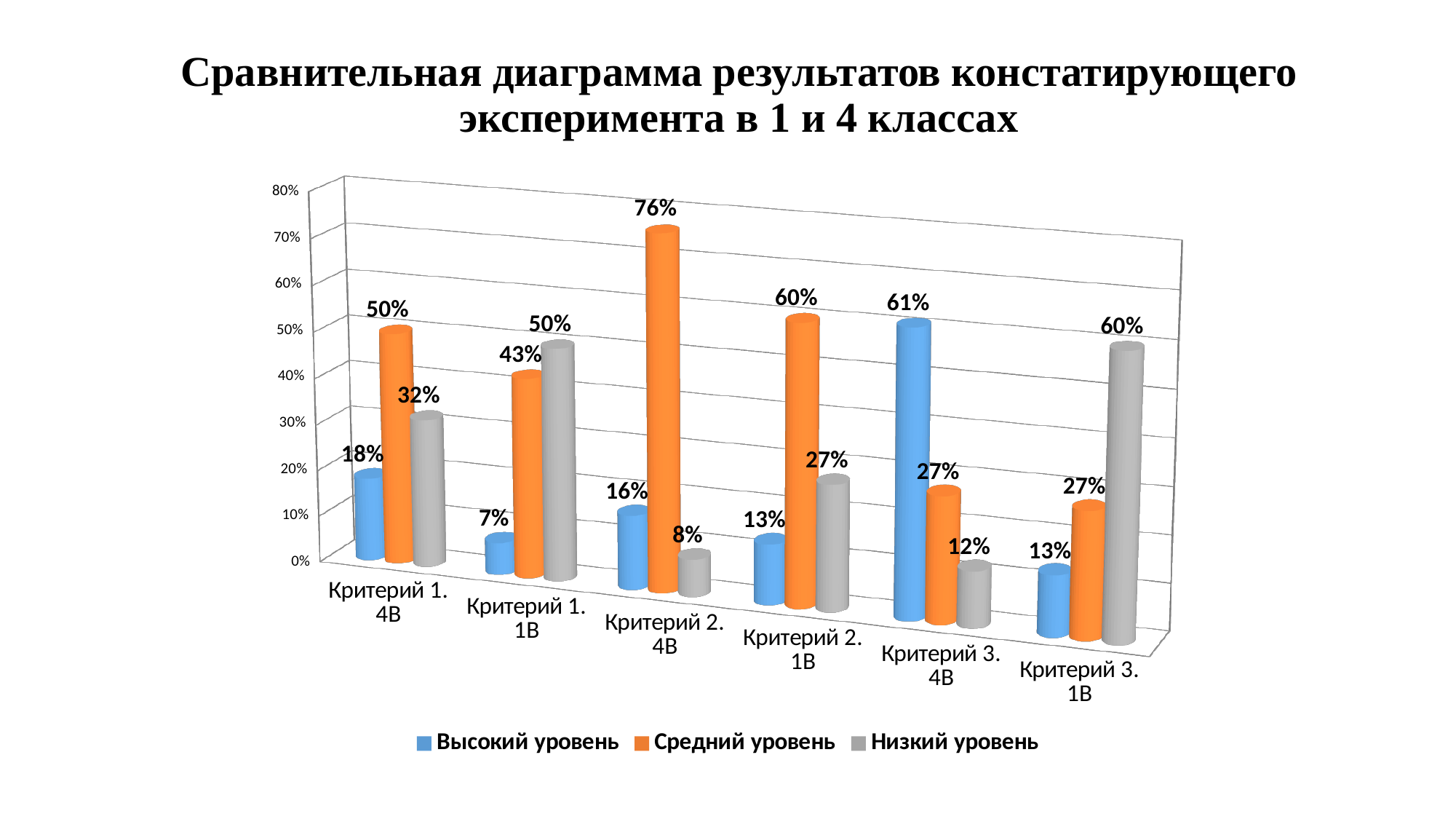
What is the value of Низкий уровень for Критерий 1. 1В? 50% What is the value of Высокий уровень for Критерий 1. 1В? 7% Which category has the lowest value for Низкий уровень? Критерий 2. 4В Which series is shown in orange in the legend? Средний уровень What kind of chart is shown on the slide? Bar chart How many series does the legend list? 3 What is the difference between Низкий уровень for Критерий 3. 1В and Низкий уровень for Критерий 3. 4В? 48% What is the value of Высокий уровень for Критерий 3. 4В? 61% Which is larger: Высокий уровень for Критерий 1. 4В or Высокий уровень for Критерий 2. 4В? Критерий 1. 4В What is the value of Средний уровень for Критерий 2. 4В? 76% Which category has the highest value for Средний уровень? Критерий 2. 4В How many categories are shown on the x axis? 6